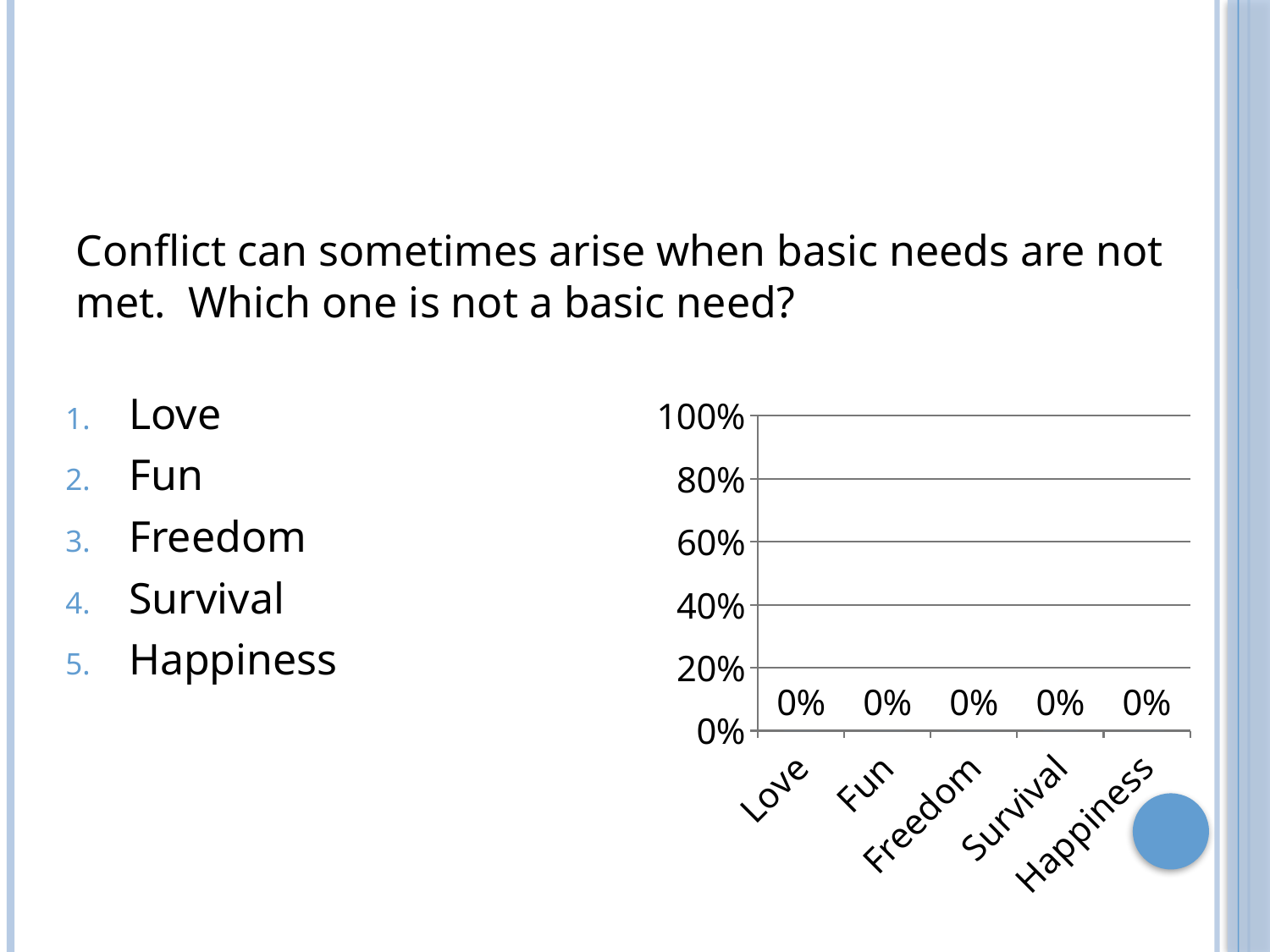
Is the value for Survival greater or less than 20%? less What is the value shown for Love? 0% What is the value shown for Fun? 0% What is the value shown for Freedom? 0% What is the value shown for Happiness? 0% How many categories are shown on the x axis of the chart? 5 What is the value shown for Survival? 0% Which category is listed last on the x axis of the chart? Happiness What is the difference between the values for Love and Happiness? 0% What kind of chart is shown on the slide? bar chart What is the highest value marked on the y axis of the chart? 100%